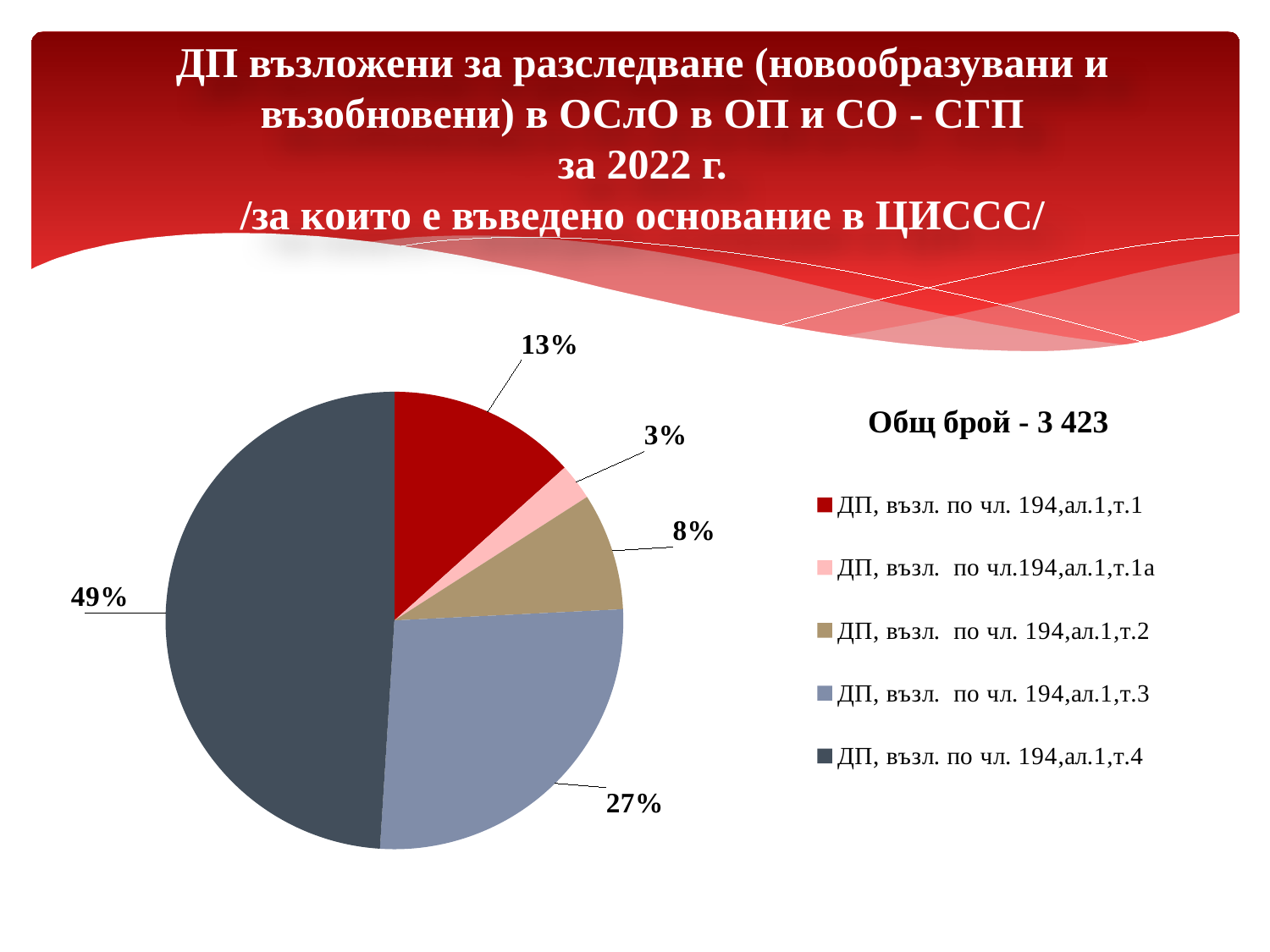
How many slices does the pie chart have? 5 Which category has the smallest slice of the pie? ДП, възл. по чл.194,ал.1,т.1а What share of the pie does "ДП, възл. по чл.194,ал.1,т.1а" represent? 3% What share of the pie does "ДП, възл. по чл. 194,ал.1,т.4" represent? 49% What kind of chart is shown on the slide? pie chart What share of the pie does "ДП, възл. по чл. 194,ал.1,т.1" represent? 13% What is the difference in percentage points between the slices for "ДП, възл. по чл. 194,ал.1,т.4" and "ДП, възл. по чл. 194,ал.1,т.3"? 22 What total number (Общ брой) is stated next to the pie chart? 3 423 Which category has the largest slice of the pie? ДП, възл. по чл. 194,ал.1,т.4 Which slice is larger: "ДП, възл. по чл. 194,ал.1,т.1" or "ДП, възл. по чл. 194,ал.1,т.2"? ДП, възл. по чл. 194,ал.1,т.1